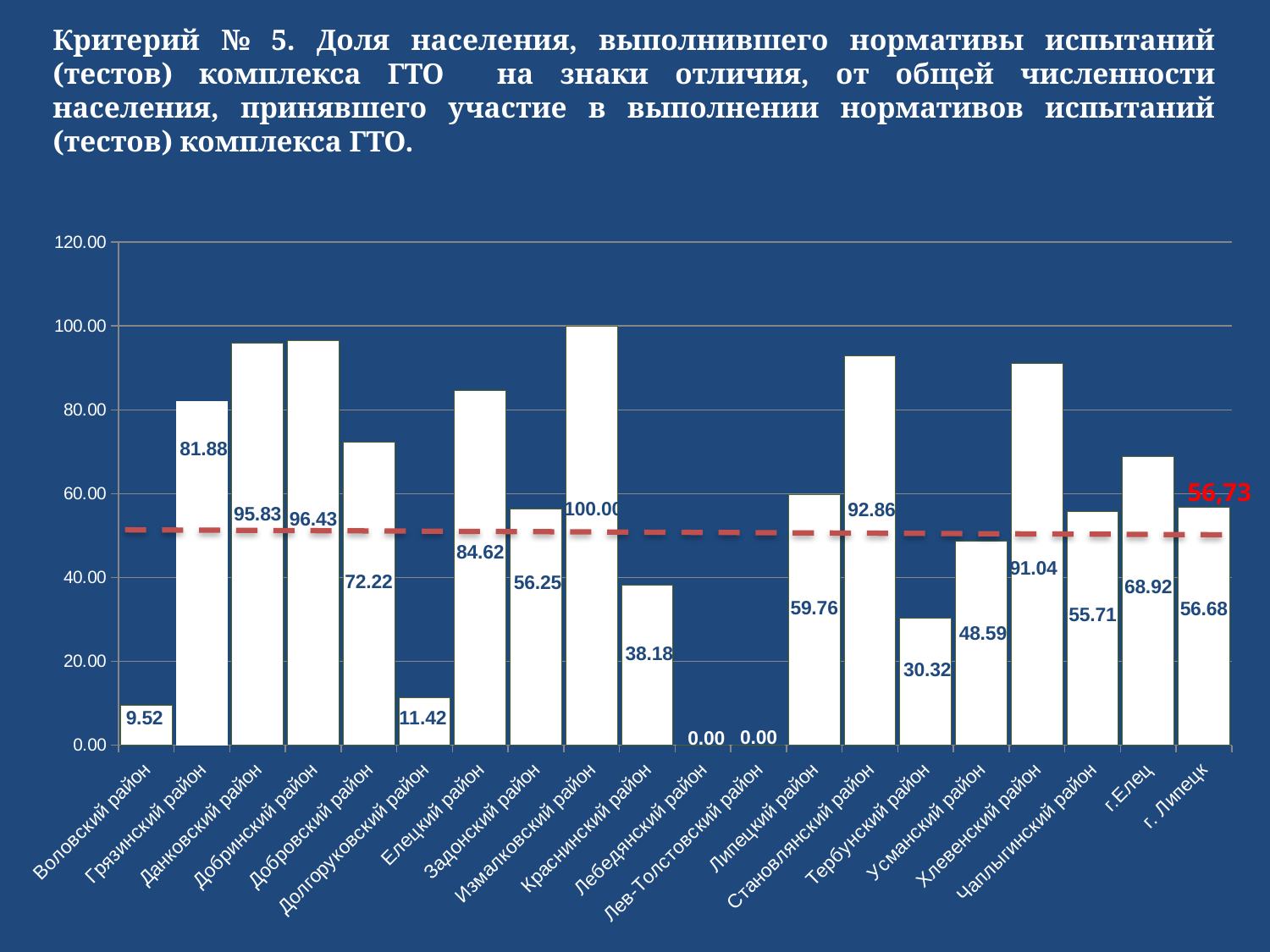
What value is labelled on the red dashed horizontal line? 56,73 Which category has the highest value? Измалковский район What is the value for Становлянский район? 92.86 How many categories are shown on the x axis? 20 Which is larger, the value for Хлевенский район or Становлянский район? Становлянский район What is the value for г. Липецк? 56.68 What is the value for Воловский район? 9.52 How many categories have a value of 0.00? 2 What is the difference between the values for Добринский район and Данковский район? 0.60 What type of chart is shown on the slide? bar chart What is the difference between the values for г.Елец and г. Липецк? 12.24 What is the value for Измалковский район? 100.00